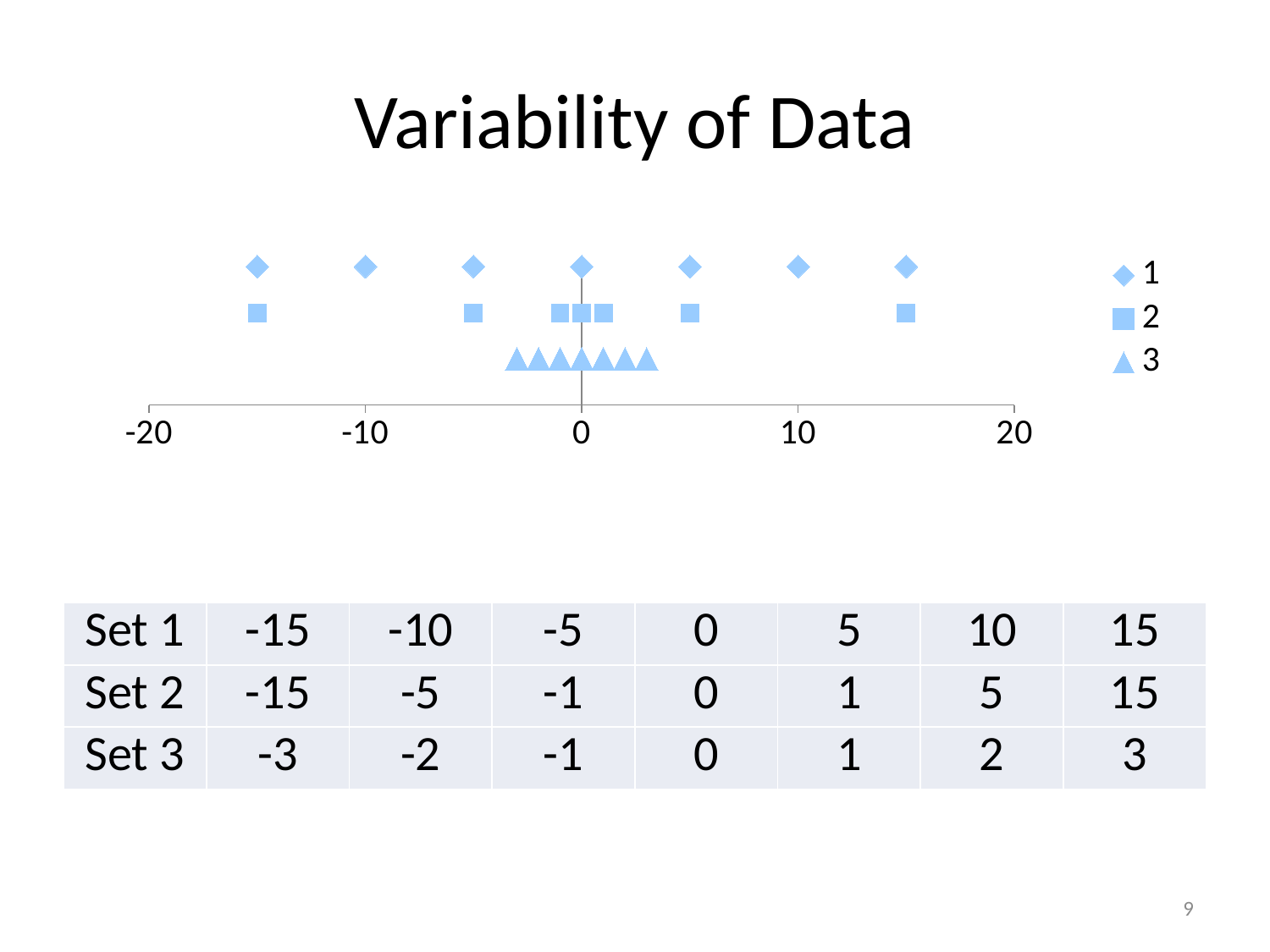
What is the difference between the largest and smallest values in series 1? 30 Is the largest value plotted for series 3 greater or less than 5? less What is the title of the slide containing the chart? Variability of Data How many data points are plotted for series 1? 7 What is the smallest value plotted for series 3? -3 How many series does the chart legend list? 3 What is the largest value plotted for series 1? 15 Which series has the widest spread of points along the x axis? 1 Which series has the larger maximum value, series 2 or series 3? 2 Which series has the narrowest spread of points along the x axis? 3 What marker shape is used for series 3 in the chart? Triangle What type of chart is shown on the slide? Scatter chart